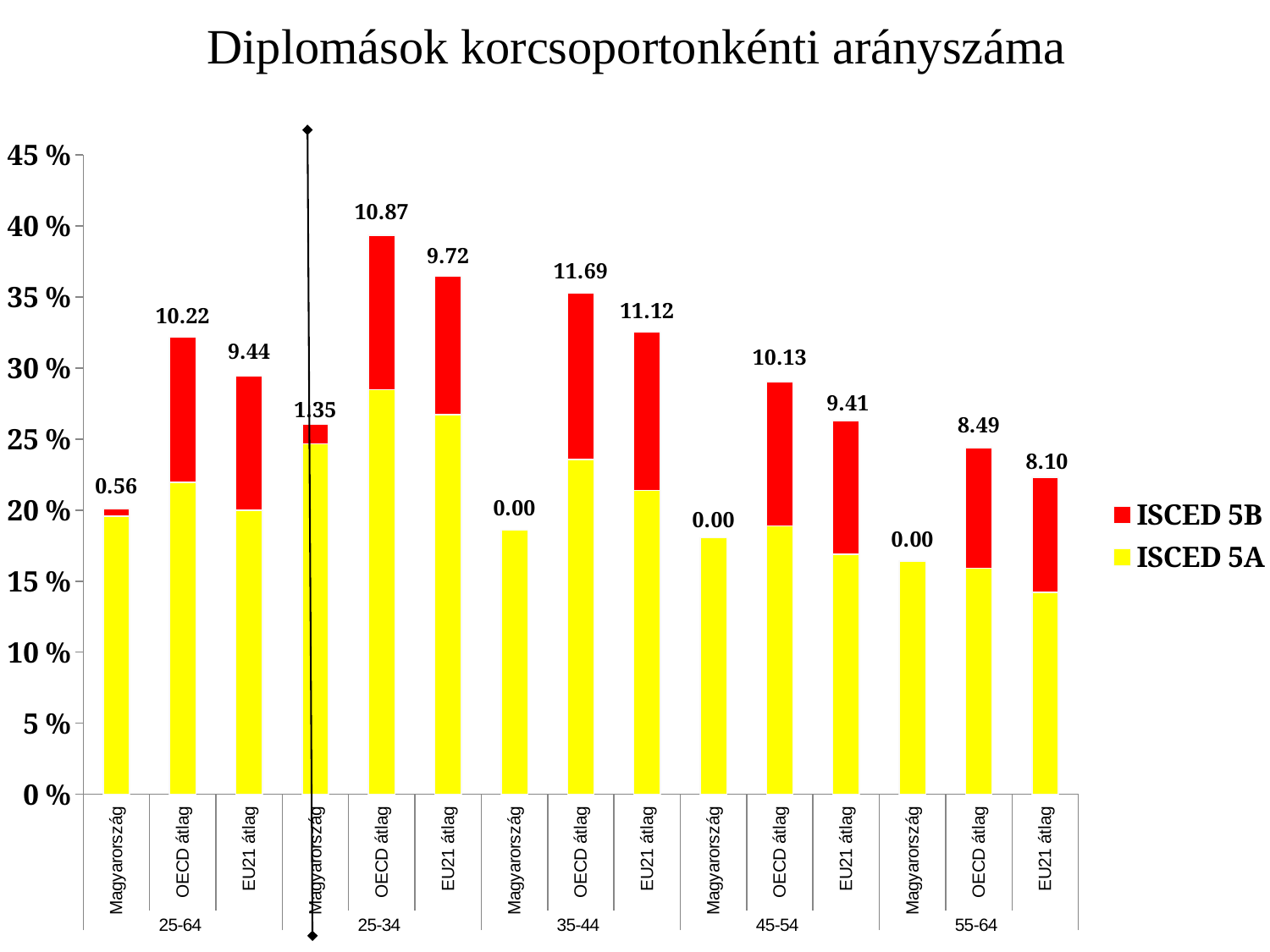
Which bar has the highest labelled ISCED 5B value? OECD átlag, 35-44 What is the ISCED 5B value for OECD átlag in the 25-34 age group? 10.87 What is the ISCED 5B value for EU21 átlag in the 55-64 age group? 8.10 Which has a larger ISCED 5B value: EU21 átlag in 25-34 or EU21 átlag in 35-44? EU21 átlag in 35-44 Which colour represents ISCED 5A in the chart? Yellow Is the total height of the Magyarország bar in the 55-64 age group greater or less than 20 %? less Is the total height of the OECD átlag bar in the 25-34 age group greater or less than 35 %? greater How many bars are plotted in the chart? 15 What is the ISCED 5B value for Magyarország in the 25-64 age group? 0.56 How many series does the legend list? 2 What is the difference between the ISCED 5B values for OECD átlag and EU21 átlag in the 45-54 age group? 0.72 What kind of chart is shown on the slide? Stacked bar chart